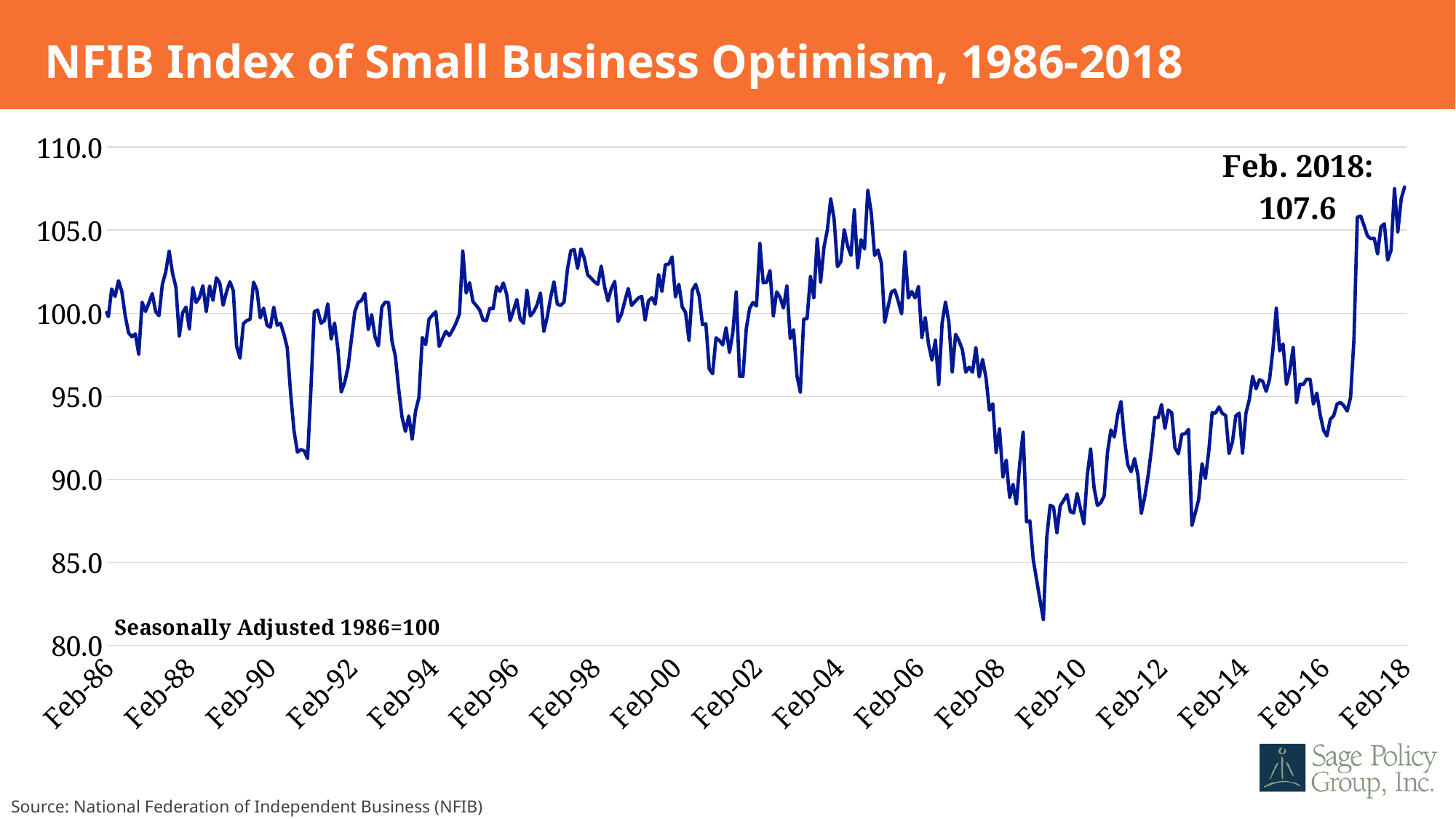
What note is printed inside the chart area near the bottom left? Seasonally Adjusted 1986=100 Is the value of the index at Feb-04 greater or less than 100? greater Between which two labelled dates on the x axis does the index reach its lowest point? Feb-08 and Feb-10 Does the index rise or fall between Feb-06 and Feb-08? fall Does the index rise or fall between Feb-16 and Feb-18? rise Is the lowest point of the index, reached between Feb-08 and Feb-10, greater or less than 85? less Is the value of the index at Feb-12 greater or less than 100? less What is the title of the chart? NFIB Index of Small Business Optimism, 1986-2018 Which is larger, the index value at Feb-18 or at Feb-10? Feb-18 What is the value of the NFIB Index of Small Business Optimism labelled for Feb. 2018? 107.6 What kind of chart is shown on the slide? Line chart